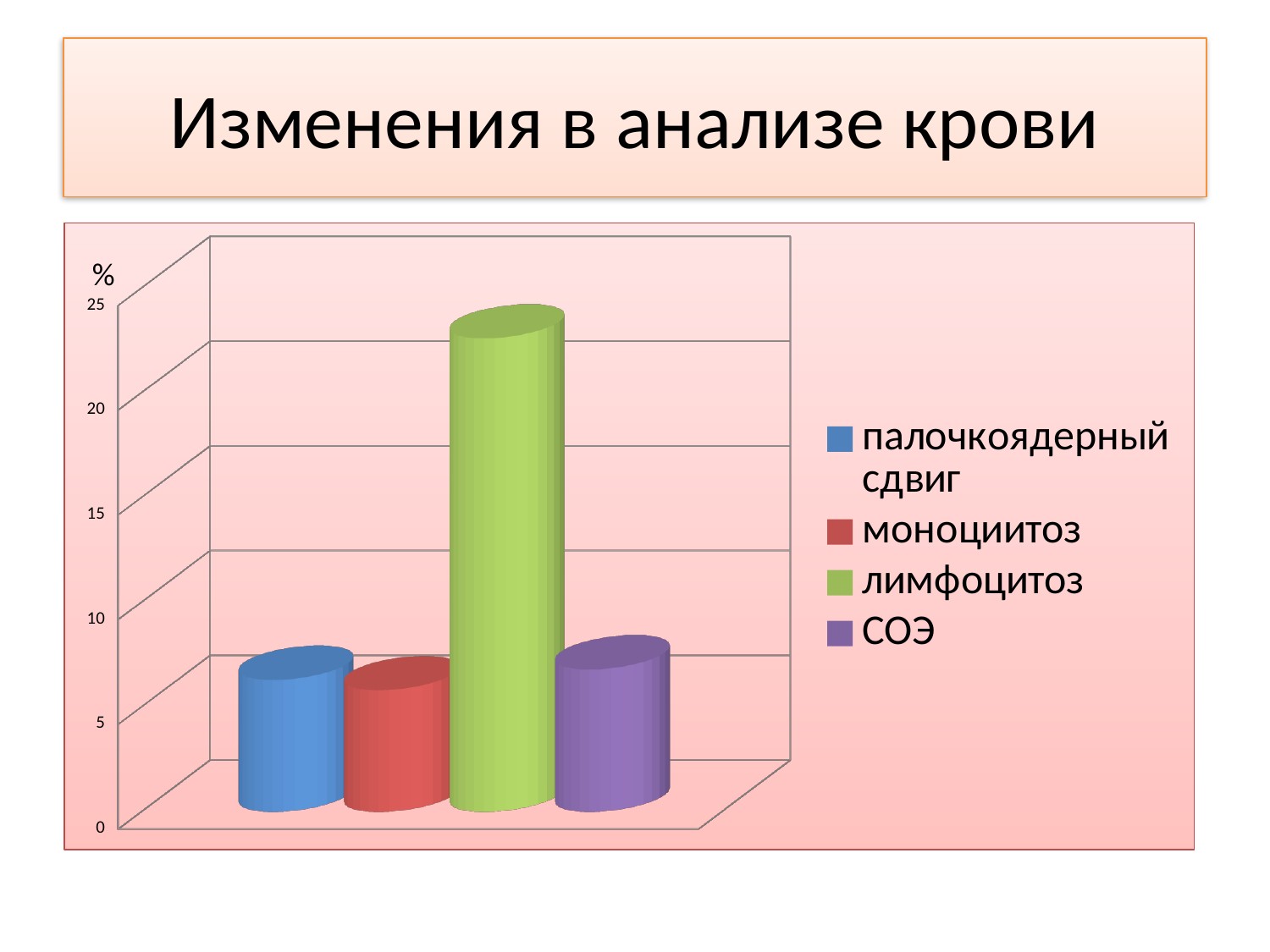
Is the value for лимфоцитоз greater or less than 15? greater Which is larger, the value for моноциитоз or the value for лимфоцитоз? лимфоцитоз Is the value for лимфоцитоз greater or less than 20? greater Is the value for палочкоядерный сдвиг greater or less than 10? less What is the title of the chart? Изменения в анализе крови What kind of chart is shown on the slide? bar chart What unit is shown on the vertical axis of the chart? % Which series has the highest value? лимфоцитоз Which is larger, the value for лимфоцитоз or the value for СОЭ? лимфоцитоз How many series does the legend list? 4